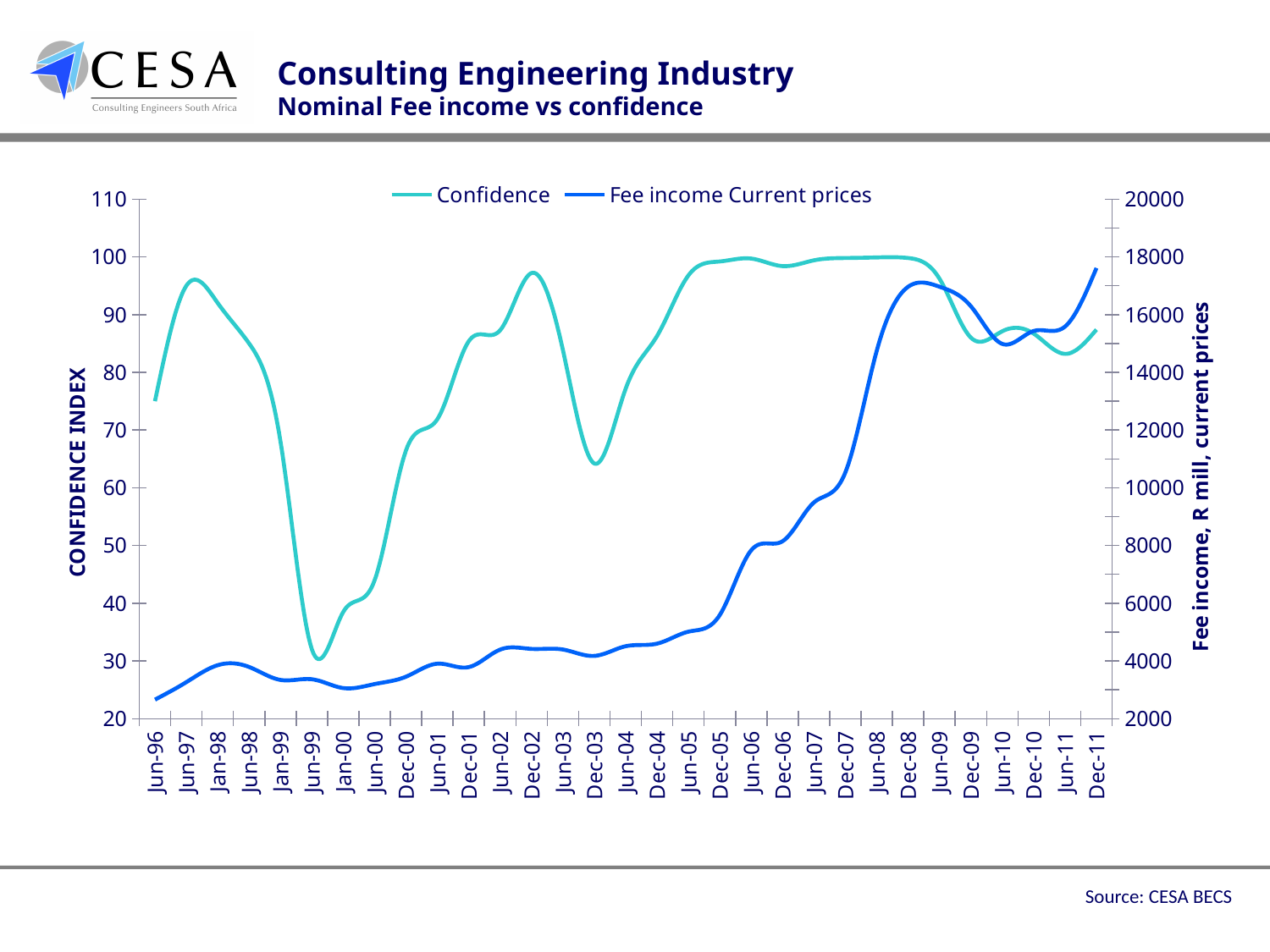
Does the Fee income Current prices series generally rise or fall from Jun-96 to Dec-08? rise How many series does the legend list? 2 Is the Fee income Current prices value at Dec-11 greater or less than 16000? greater What is the title of the right-hand vertical axis? Fee income, R mill, current prices Is the Fee income Current prices value at Jun-96 greater or less than 4000? less What are the two series named in the legend? Confidence and Fee income Current prices What kind of chart is shown on the slide? Line chart Is the Confidence value at Dec-02 greater or less than 90? greater At which date does the Confidence series reach its lowest point? Jun-99 Which is higher, the Confidence value at Jun-97 or at Jun-99? Jun-97